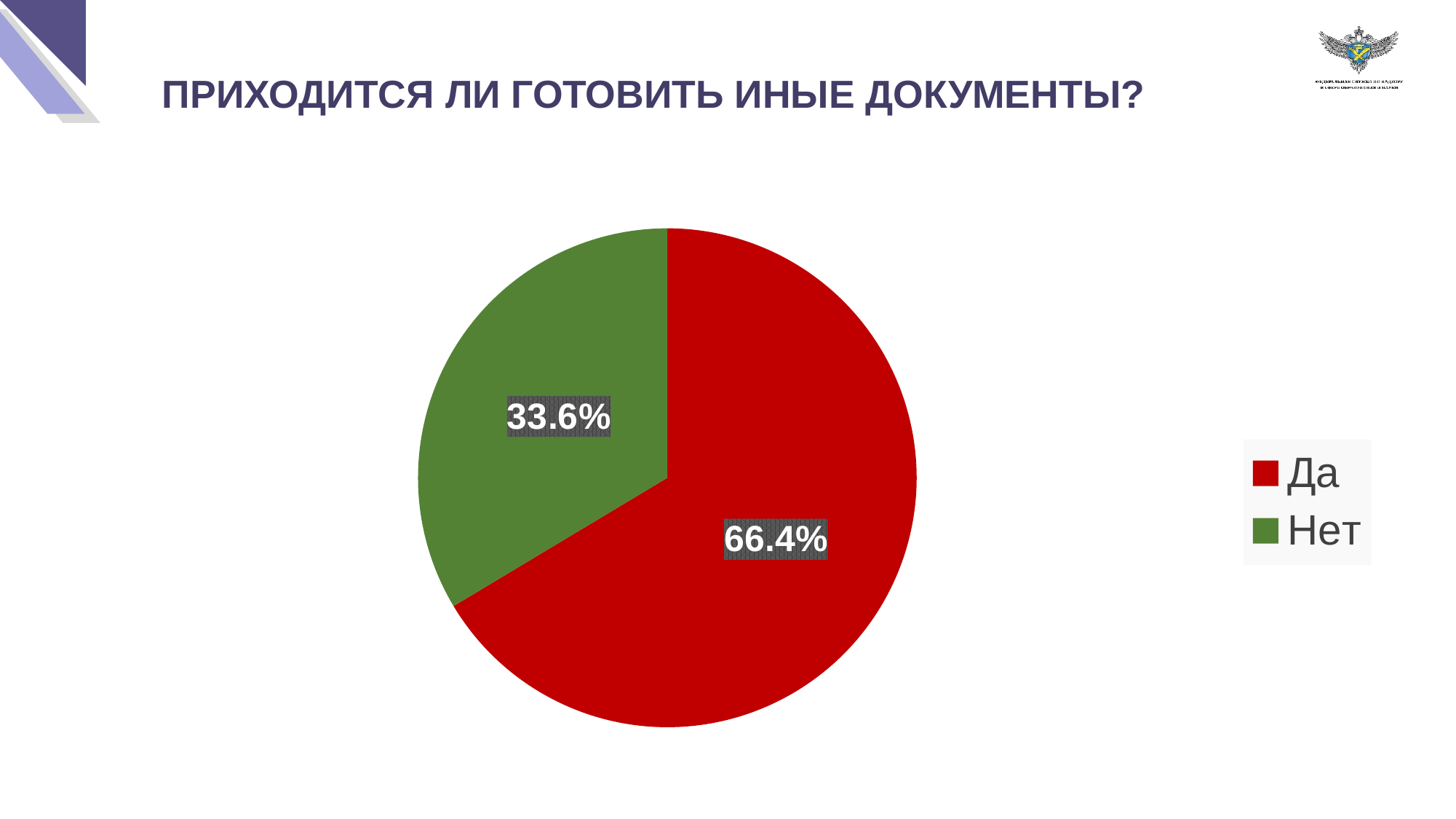
Which category has the smallest share of the pie? Нет Which category has the largest share of the pie? Да How many slices does the pie chart have? 2 What is the title of the slide above the chart? ПРИХОДИТСЯ ЛИ ГОТОВИТЬ ИНЫЕ ДОКУМЕНТЫ? What share of the pie does the "Нет" slice represent? 33.6% Which is larger, the share for "Да" or the share for "Нет"? Да What colour is the "Да" slice? red How many entries does the legend list? 2 What is the value for "Нет"? 33.6% What is the value for "Да"? 66.4% What is the difference between the shares for "Да" and "Нет"? 32.8% What kind of chart is shown on the slide? pie chart